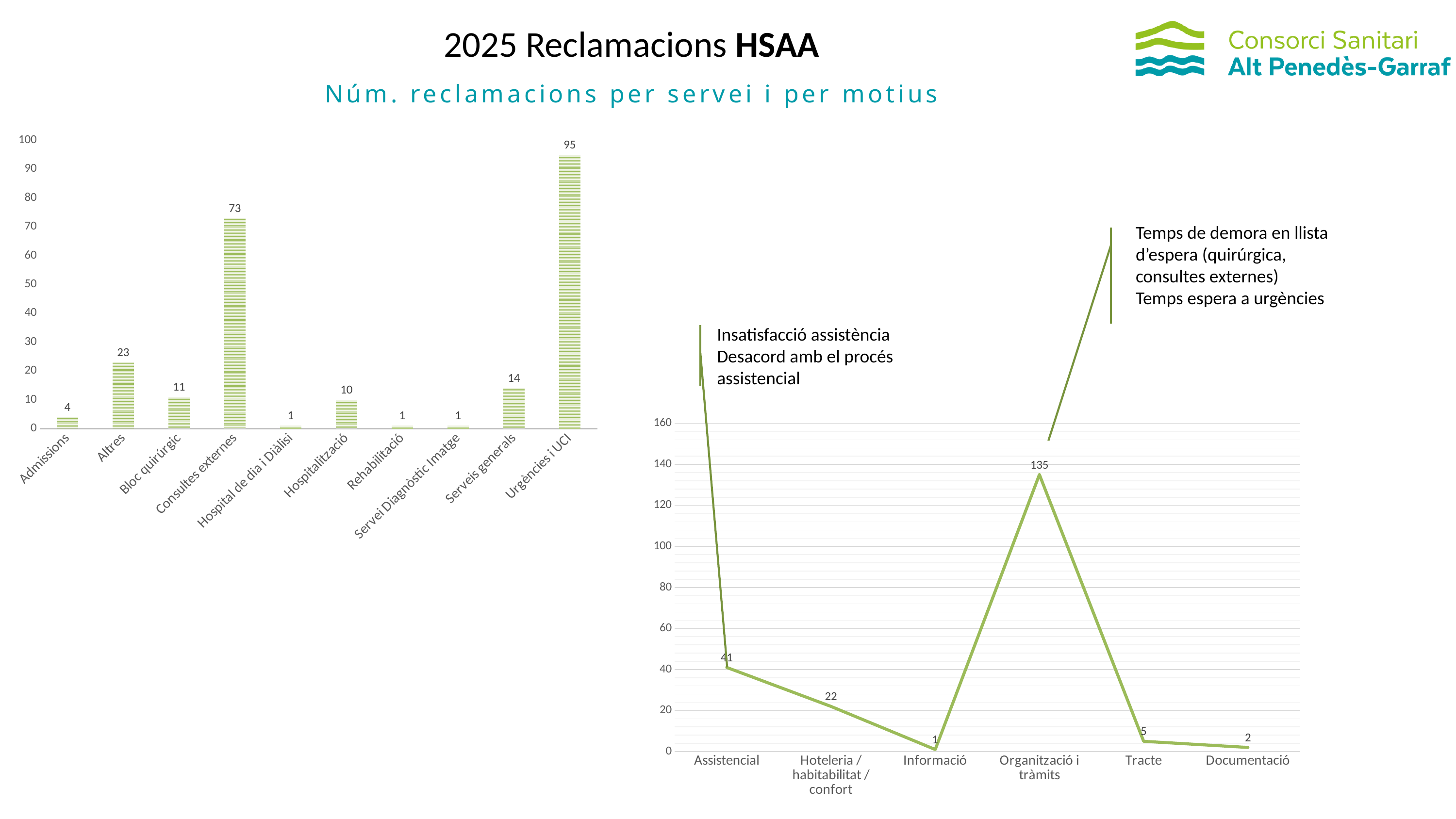
In the bar chart on the left, what is the value for Consultes externes? 73 In the bar chart on the left, what is the difference between the values for Urgències i UCI and Consultes externes? 22 How many categories are plotted in the line chart on the right? 6 In the line chart on the right, which motiu has the lowest value? Informació In the bar chart on the left, how many reclamacions are shown for Urgències i UCI? 95 How many service categories are shown in the bar chart on the left? 10 In the line chart on the right, what is the difference between the values for Organització i tràmits and Assistencial? 94 In the line chart on the right, what is the value for Organització i tràmits? 135 In the bar chart on the left, which is larger, the value for Altres or the value for Serveis generals? Altres What kind of chart is the chart on the left of the slide? Bar chart In the line chart on the right, what is the value for Hoteleria / habitabilitat / confort? 22 In the bar chart on the left, which service has the highest number of reclamacions? Urgències i UCI